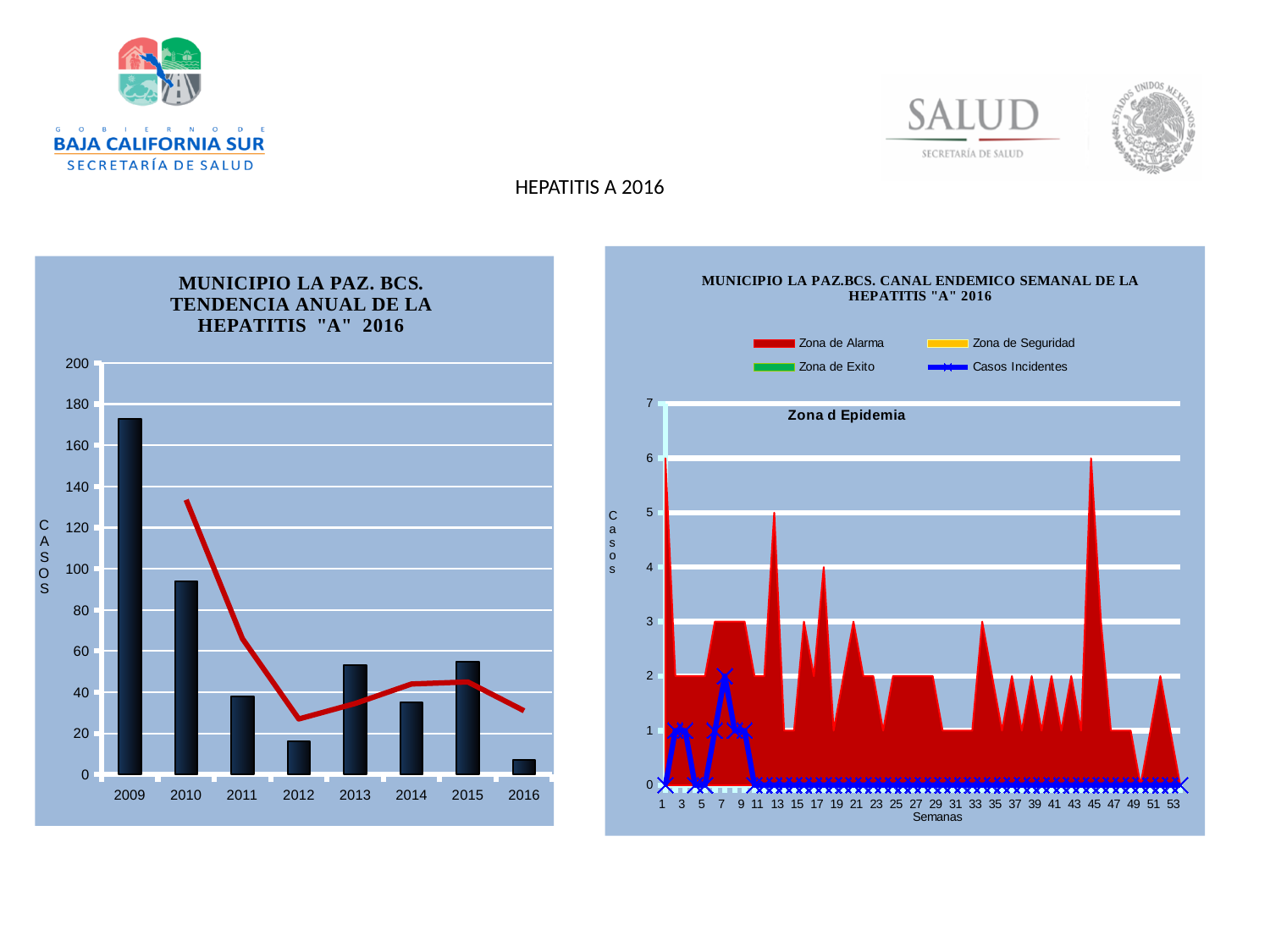
On the left chart (Tendencia Anual), which year has the lowest number of cases? 2016 On the right chart (Canal Endemico Semanal), how many entries does the legend list? 4 On the left chart (Tendencia Anual), do the bars generally rise or fall from 2009 to 2012? Fall On the right chart (Canal Endemico Semanal), what colour represents the Zona de Alarma? Red On the left chart (Tendencia Anual), is the value for 2012 greater or less than 20? less On the left chart (Tendencia Anual), which year has the highest number of cases? 2009 On the left chart (Tendencia Anual), how many years are shown on the x axis? 8 On the left chart (Tendencia Anual), is the value for 2009 greater or less than 160? greater On the left chart (Tendencia Anual), which year has more cases, 2010 or 2011? 2010 On the right chart (Canal Endemico Semanal), what is the label on the x axis? Semanas On the left chart (Tendencia Anual), is the value for 2010 greater or less than 100? less What kind of chart is the left chart (Tendencia Anual)? Bar chart